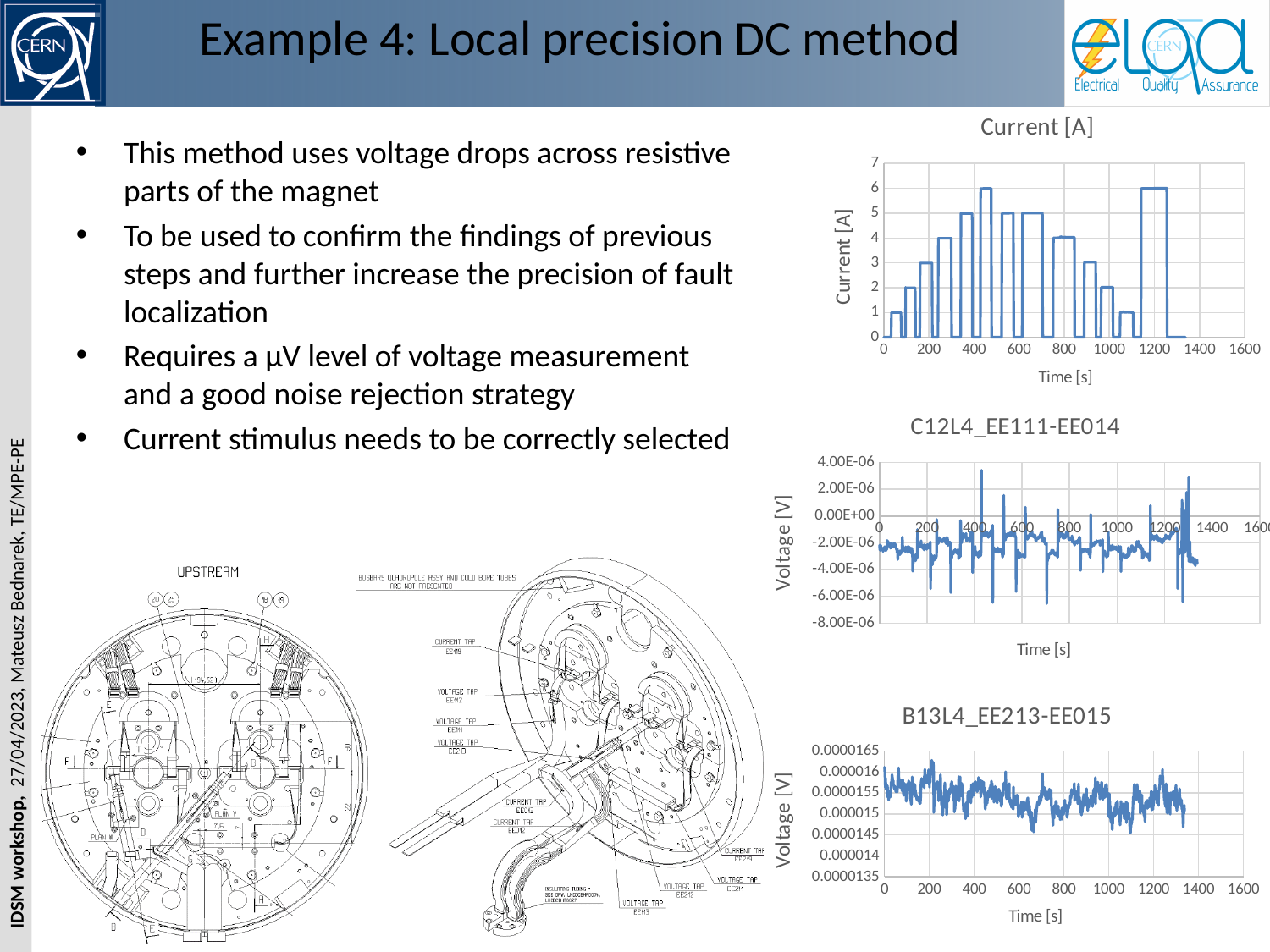
In the 'Current [A]' chart, is the current at 1000 s greater or less than 3? less In the 'Current [A]' chart, what is the highest current value reached? 6 In the 'B13L4_EE213-EE015' chart, is the highest voltage value greater or less than 0.0000165? less In the 'C12L4_EE111-EE014' chart, is the voltage at 1000 s greater or less than 0.00E+00? less What is the title of the middle chart on the right? C12L4_EE111-EE014 In the 'Current [A]' chart, how many separate plateaus reach 6 A? 2 What is the y-axis label of the 'B13L4_EE213-EE015' chart? Voltage [V] In the 'Current [A]' chart, what is the lowest current value shown? 0 In the 'Current [A]' chart, does the current rise or fall between 0 s and 400 s? rise What kind of chart is the 'Current [A]' chart at the top right? line chart How many charts are shown on the slide? 3